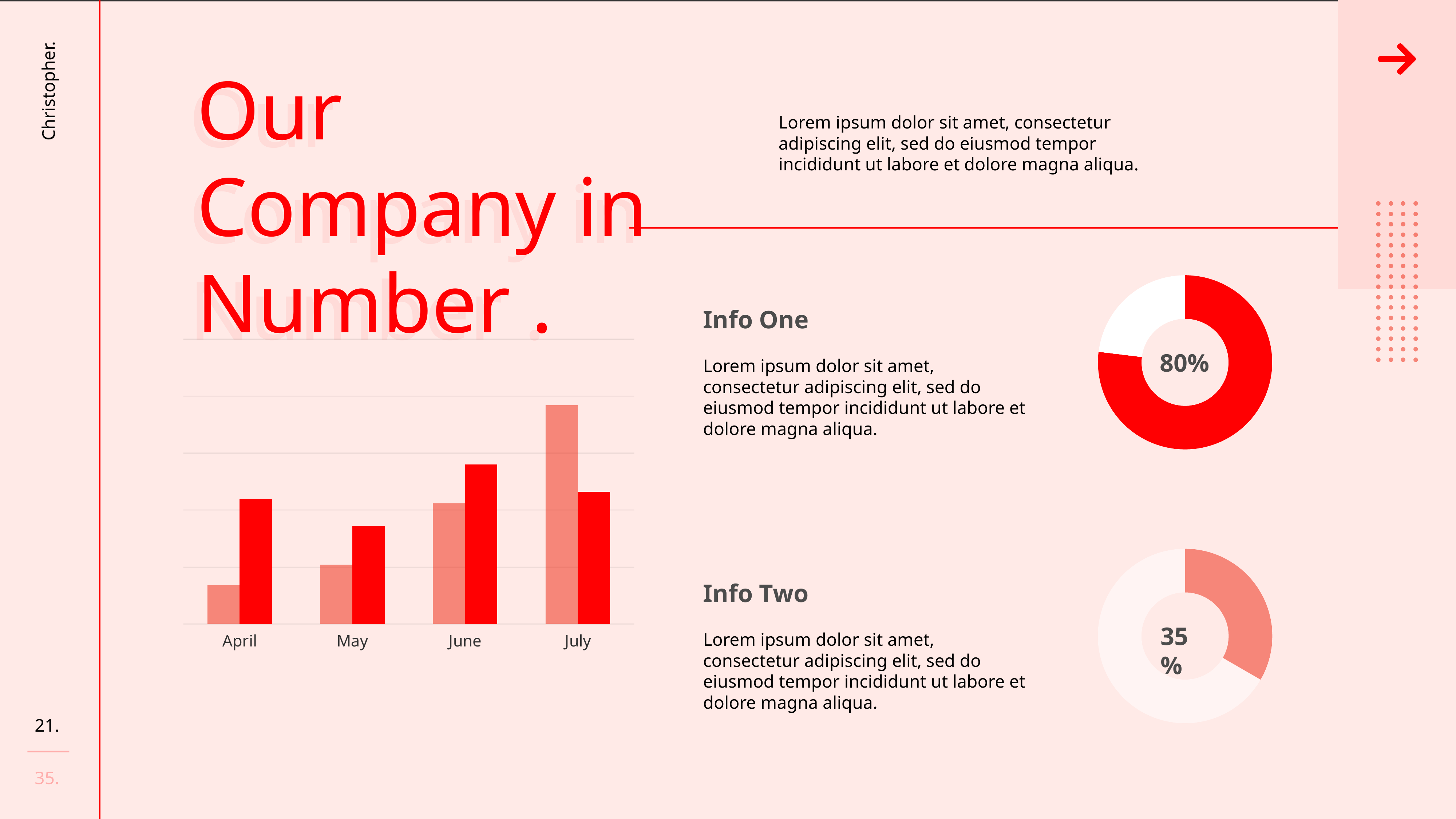
In the bar chart at the bottom left, do the light red bars rise or fall from April to July? Rise What percentage is shown in the donut chart next to Info One? 80% In the bar chart at the bottom left, for April, which bar is taller: the light red bar or the bright red bar? The bright red bar How many bars are plotted for each month in the bar chart at the bottom left? 2 In the bar chart at the bottom left, which month has the shortest light red bar? April What percentage is shown in the donut chart next to Info Two? 35% In the bar chart at the bottom left, which month has the tallest light red bar? July In the bar chart at the bottom left, which month has the shortest bright red bar? May What kind of chart is the chart at the bottom left of the slide, below the title? Bar chart In the bar chart at the bottom left, which month has the tallest bright red bar? June In the bar chart at the bottom left, for July, which bar is taller: the light red bar or the bright red bar? The light red bar How many months are shown on the x axis of the bar chart at the bottom left? 4